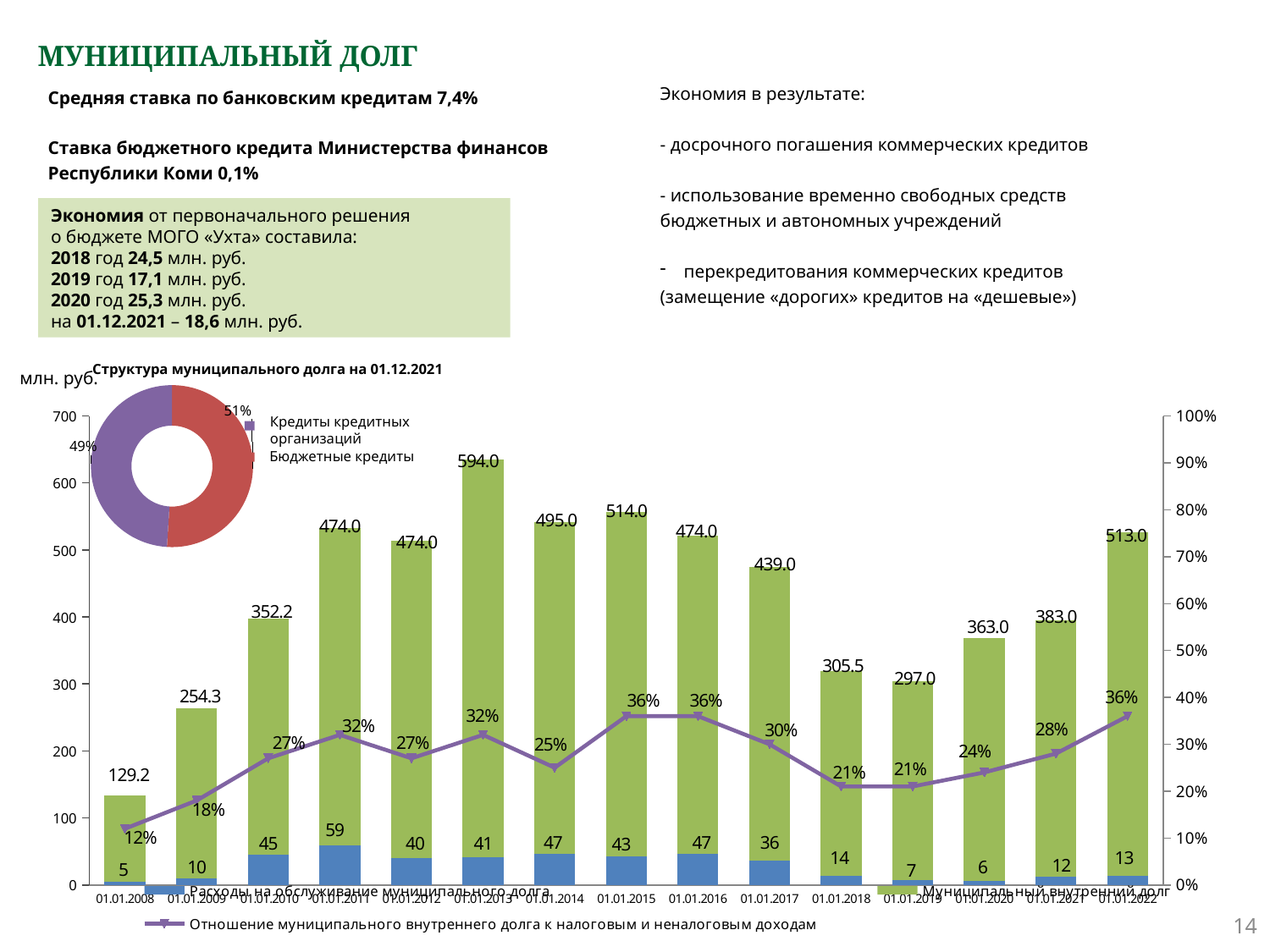
In the large bar-and-line chart, which date has the lowest labelled value of Муниципальный внутренний долг? 01.01.2008 In the large bar-and-line chart, what is the labelled value of Муниципальный внутренний долг for 01.01.2013? 594.0 In the donut chart 'Структура муниципального долга на 01.12.2021', what share is labelled for Бюджетные кредиты? 51% How many series does the legend of the large bar-and-line chart list? 3 How many dates are shown on the x axis of the large bar-and-line chart? 15 In the large bar-and-line chart, what is the difference between the Муниципальный внутренний долг values for 01.01.2022 and 01.01.2021? 130.0 In the large bar-and-line chart, which is larger: Расходы на обслуживание муниципального долга for 01.01.2010 or for 01.01.2017? 01.01.2010 In the large bar-and-line chart, which date has the highest labelled value of Муниципальный внутренний долг? 01.01.2013 What kind of chart is 'Структура муниципального долга на 01.12.2021'? Donut (pie) chart In the large bar-and-line chart, what percentage is labelled on the line for 01.01.2022? 36% In the large bar-and-line chart, what is the labelled value of Расходы на обслуживание муниципального долга for 01.01.2011? 59 In the donut chart 'Структура муниципального долга на 01.12.2021', what share is labelled for Кредиты кредитных организаций? 49%